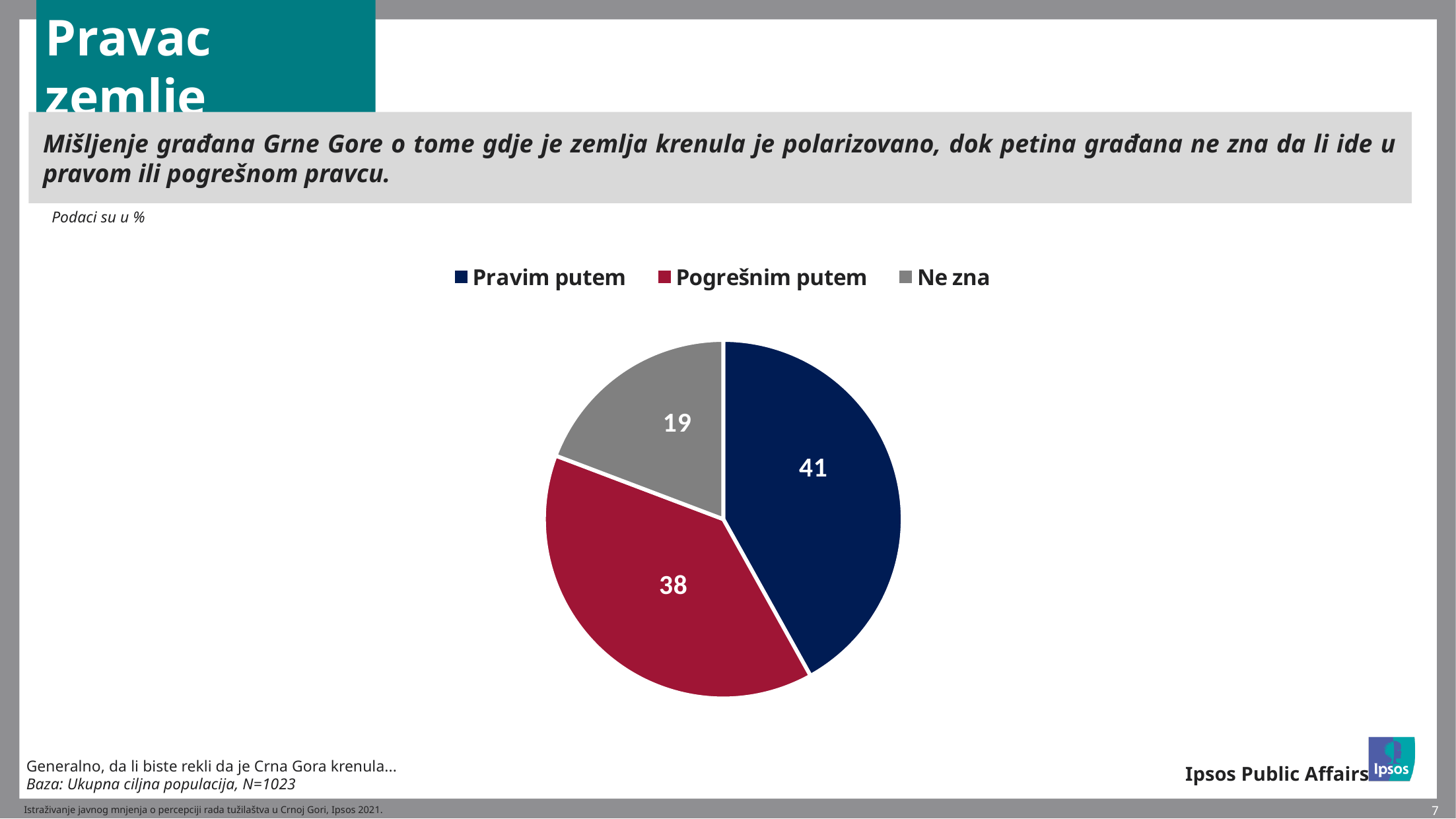
What is the difference between the values for "Pogrešnim putem" and "Ne zna"? 19 How many entries does the legend list? 3 What is the difference between the values for "Pravim putem" and "Pogrešnim putem"? 3 What is the value for "Ne zna"? 19 What is the value for "Pravim putem"? 41 How many slices does the pie chart have? 3 Which category has the smallest slice of the pie? Ne zna What colour is the slice for "Ne zna"? grey Which is larger, the value for "Pogrešnim putem" or the value for "Ne zna"? Pogrešnim putem What is the value for "Pogrešnim putem"? 38 What kind of chart is shown on the slide? pie chart Which category has the largest slice of the pie? Pravim putem